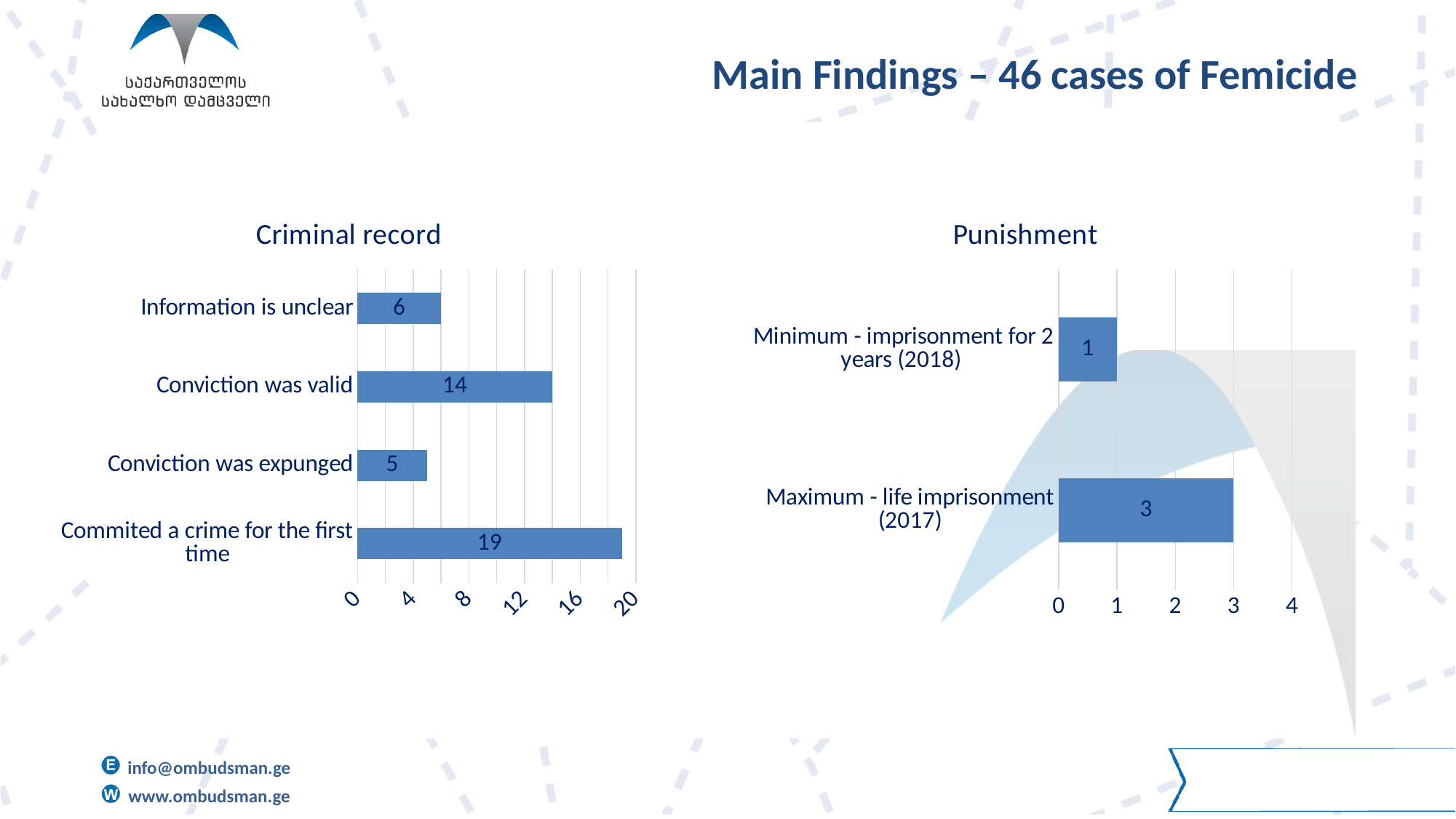
In the 'Punishment' chart, what is the value for 'Minimum - imprisonment for 2 years (2018)'? 1 In the 'Criminal record' chart, what is the value for 'Conviction was valid'? 14 In the 'Punishment' chart, what is the difference between 'Maximum - life imprisonment (2017)' and 'Minimum - imprisonment for 2 years (2018)'? 2 What kind of chart is the 'Criminal record' chart? Bar chart In the 'Punishment' chart, what is the value for 'Maximum - life imprisonment (2017)'? 3 In the 'Criminal record' chart, which category has the highest value? Commited a crime for the first time In the 'Criminal record' chart, which category has the lowest value? Conviction was expunged How many categories does the 'Punishment' chart show? 2 In the 'Criminal record' chart, what is the value for 'Commited a crime for the first time'? 19 How many categories does the 'Criminal record' chart show? 4 In the 'Criminal record' chart, what is the difference between 'Commited a crime for the first time' and 'Conviction was valid'? 5 In the 'Criminal record' chart, which is larger: 'Information is unclear' or 'Conviction was expunged'? Information is unclear